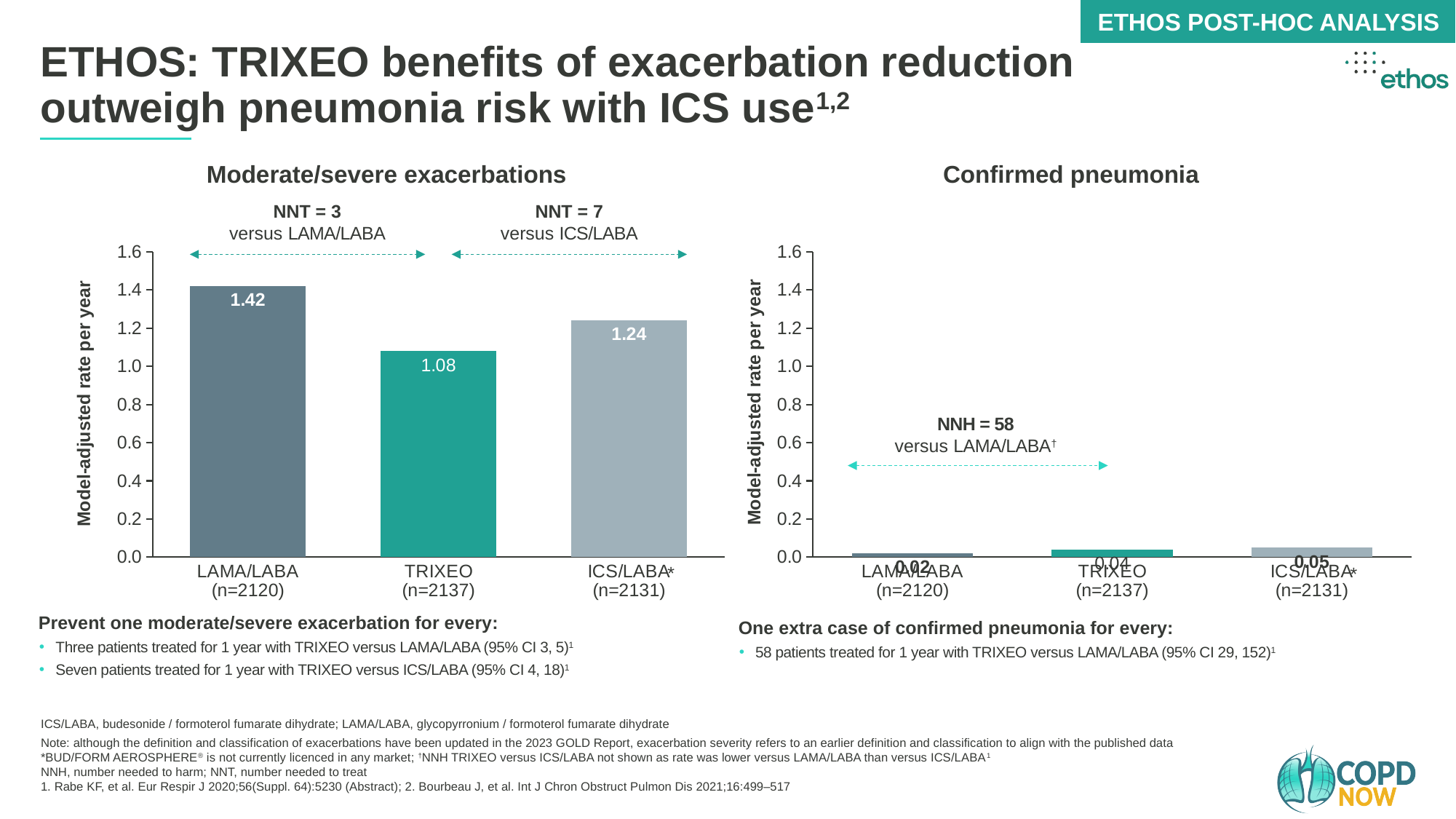
In the Moderate/severe exacerbations chart, which treatment has the highest model-adjusted rate per year? LAMA/LABA In the Confirmed pneumonia chart, which treatment has the highest model-adjusted rate per year? ICS/LABA In the Confirmed pneumonia chart, what is the model-adjusted rate per year for TRIXEO? 0.04 What type of chart is the Moderate/severe exacerbations chart? Bar chart How many treatment categories are shown in the Confirmed pneumonia chart? 3 In the Moderate/severe exacerbations chart, which treatment has the lowest model-adjusted rate per year? TRIXEO In the Moderate/severe exacerbations chart, what is the model-adjusted rate per year for ICS/LABA? 1.24 In the Confirmed pneumonia chart, which treatment has the lowest model-adjusted rate per year? LAMA/LABA In the Moderate/severe exacerbations chart, what is the model-adjusted rate per year for TRIXEO? 1.08 In the Moderate/severe exacerbations chart, is the rate for ICS/LABA greater or less than 1.2? greater In the Moderate/severe exacerbations chart, what is the difference between the LAMA/LABA and TRIXEO rates? 0.34 In the Moderate/severe exacerbations chart, what is the model-adjusted rate per year for LAMA/LABA? 1.42